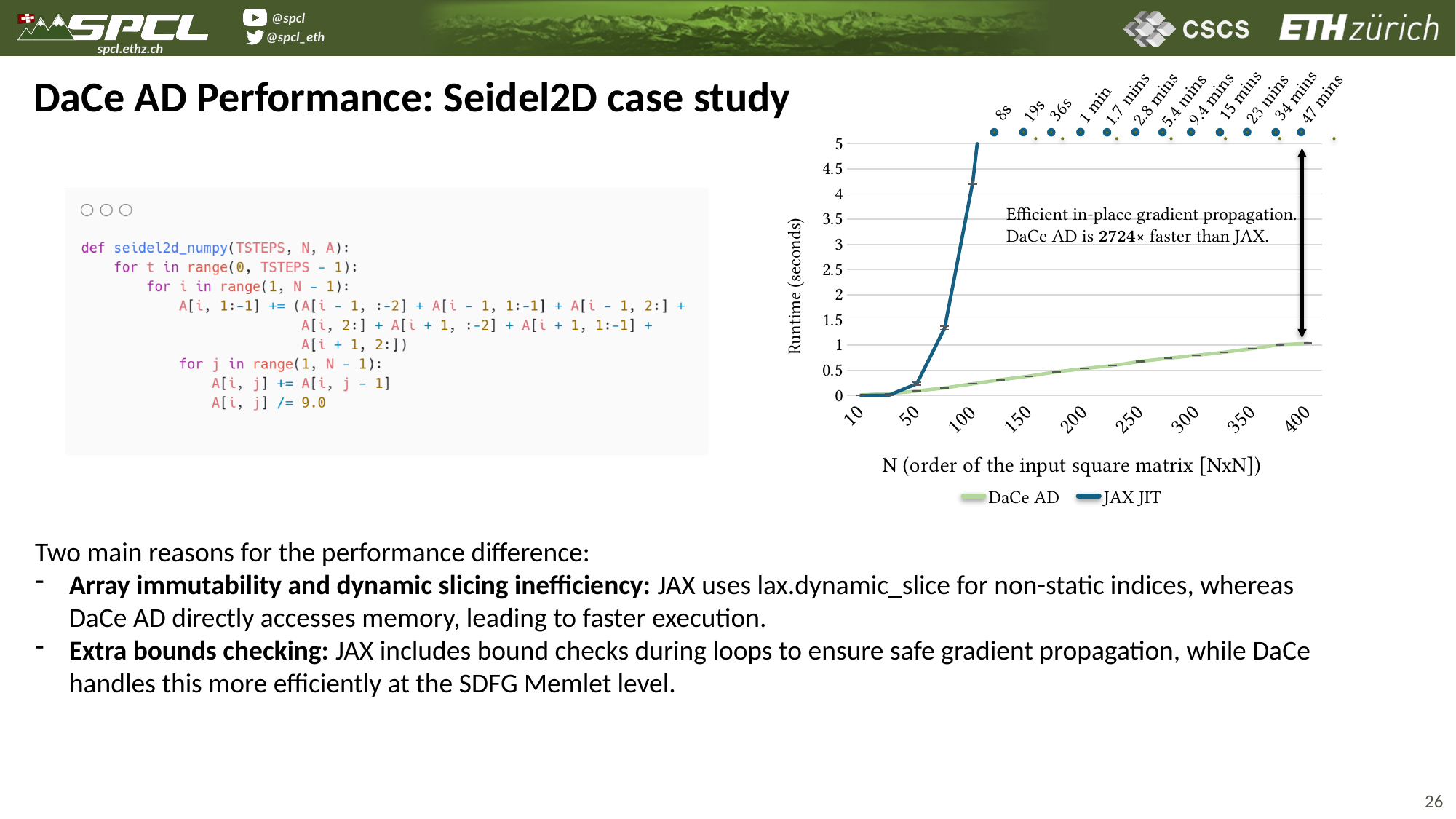
Is the DaCe AD runtime at N = 300 greater or less than 1 second? less Is the JAX JIT runtime at N = 100 greater or less than 4 seconds? greater What is the label of the chart's y axis? Runtime (seconds) According to the annotation on the chart, how many times faster is DaCe AD than JAX? 2724× Does the DaCe AD runtime rise or fall as N increases from 10 to 400? rise What runtime is annotated for JAX JIT at the largest N shown (N = 400)? 47 mins What kind of chart is shown on the slide? line chart How many series does the chart legend list? 2 How many JAX JIT runtime annotations (e.g. 8s, 19s, ...) are printed above the chart? 12 Which series has the larger runtime at N = 100? JAX JIT What is the highest value shown on the chart's y axis? 5 What are the two series named in the chart legend? DaCe AD and JAX JIT